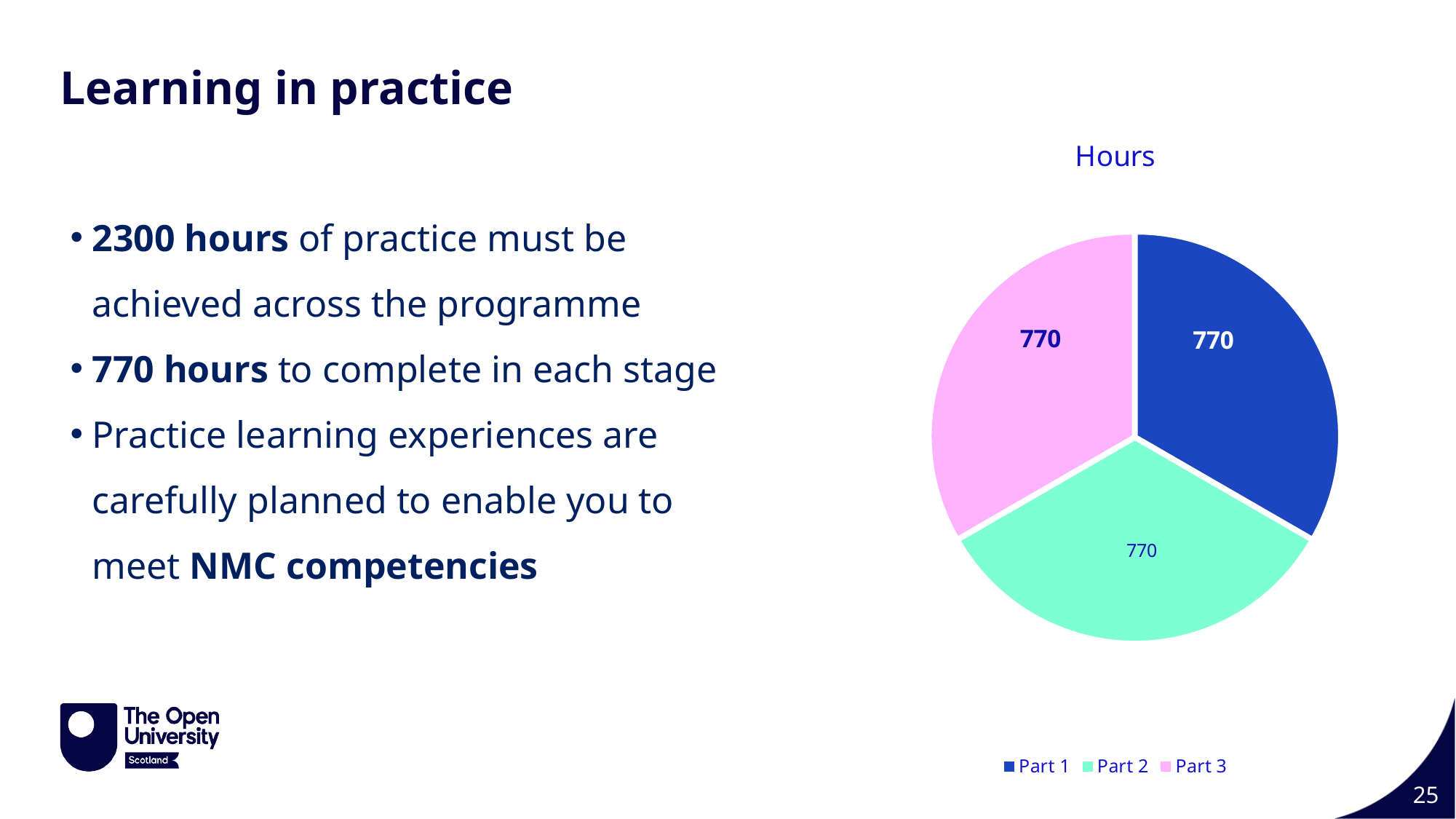
What is the total of all three slices in the pie chart? 2310 What is the value for Part 1 in the pie chart? 770 What is the value for Part 2 in the pie chart? 770 What type of chart is shown on the slide? pie chart Which colour represents Part 3 in the pie chart? pink What share of the pie does Part 2 represent? one third What is the value for Part 3 in the pie chart? 770 How many entries does the chart legend list? 3 What is the difference between the values for Part 1 and Part 3? 0 How many slices does the pie chart have? 3 What is the title of the chart? Hours Is the value for Part 1 greater or less than 500? greater